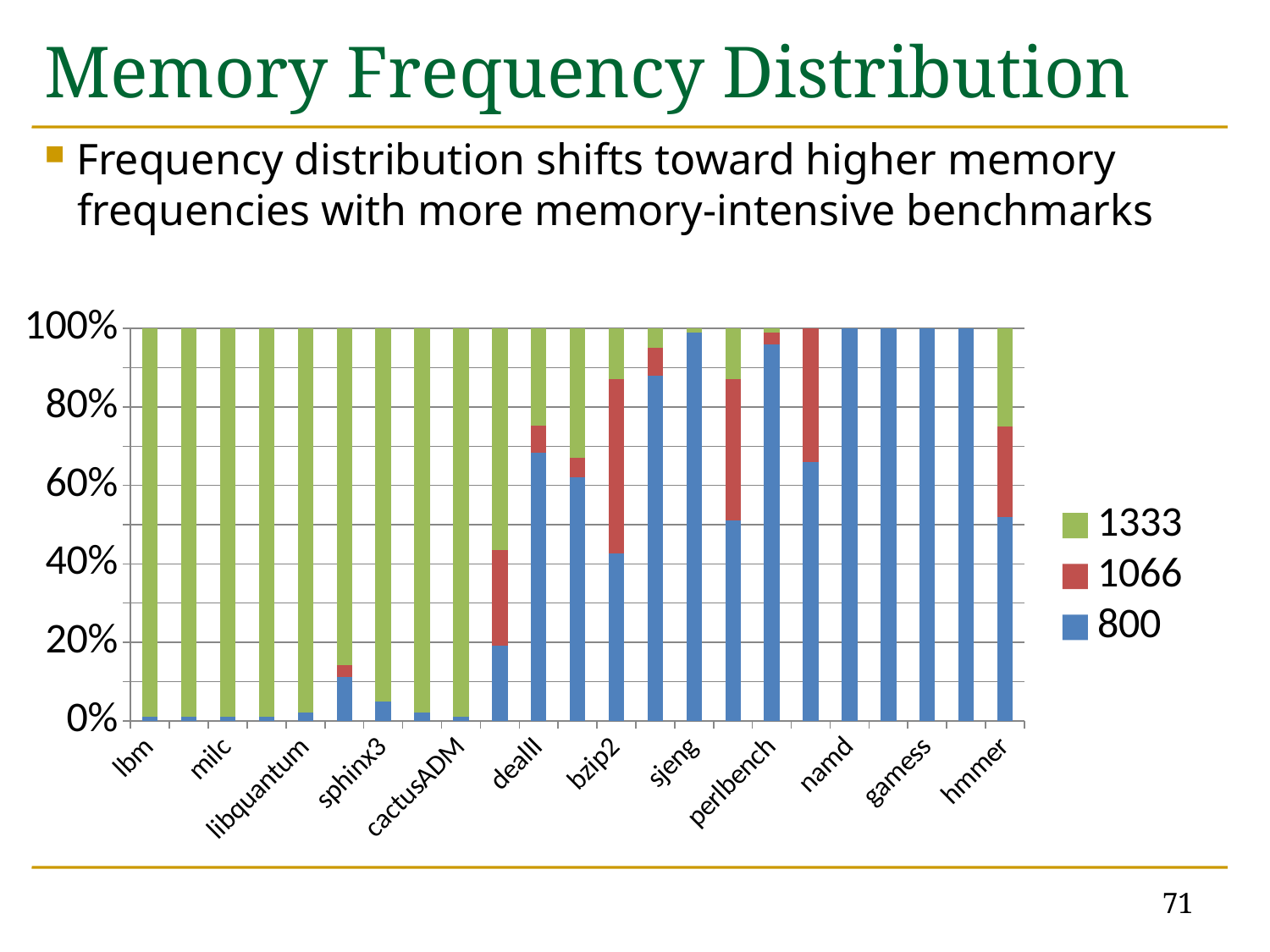
Moving from left to right along the x axis, does the 800 share generally rise or fall? rise Is the 800 share for hmmer greater or less than 40%? greater Which has the larger 800 share, lbm or namd? namd What are the three series named in the legend? 1333, 1066, 800 How many series does the legend list? 3 Is the 800 share for sphinx3 greater or less than 20%? less Is the 800 share for bzip2 greater or less than 60%? less Among the labelled benchmarks, which has the largest 1066 share? bzip2 Which colour represents the 800 series in the chart? blue What kind of chart is shown on the slide? stacked bar chart Which has the larger 1333 share, milc or gamess? milc